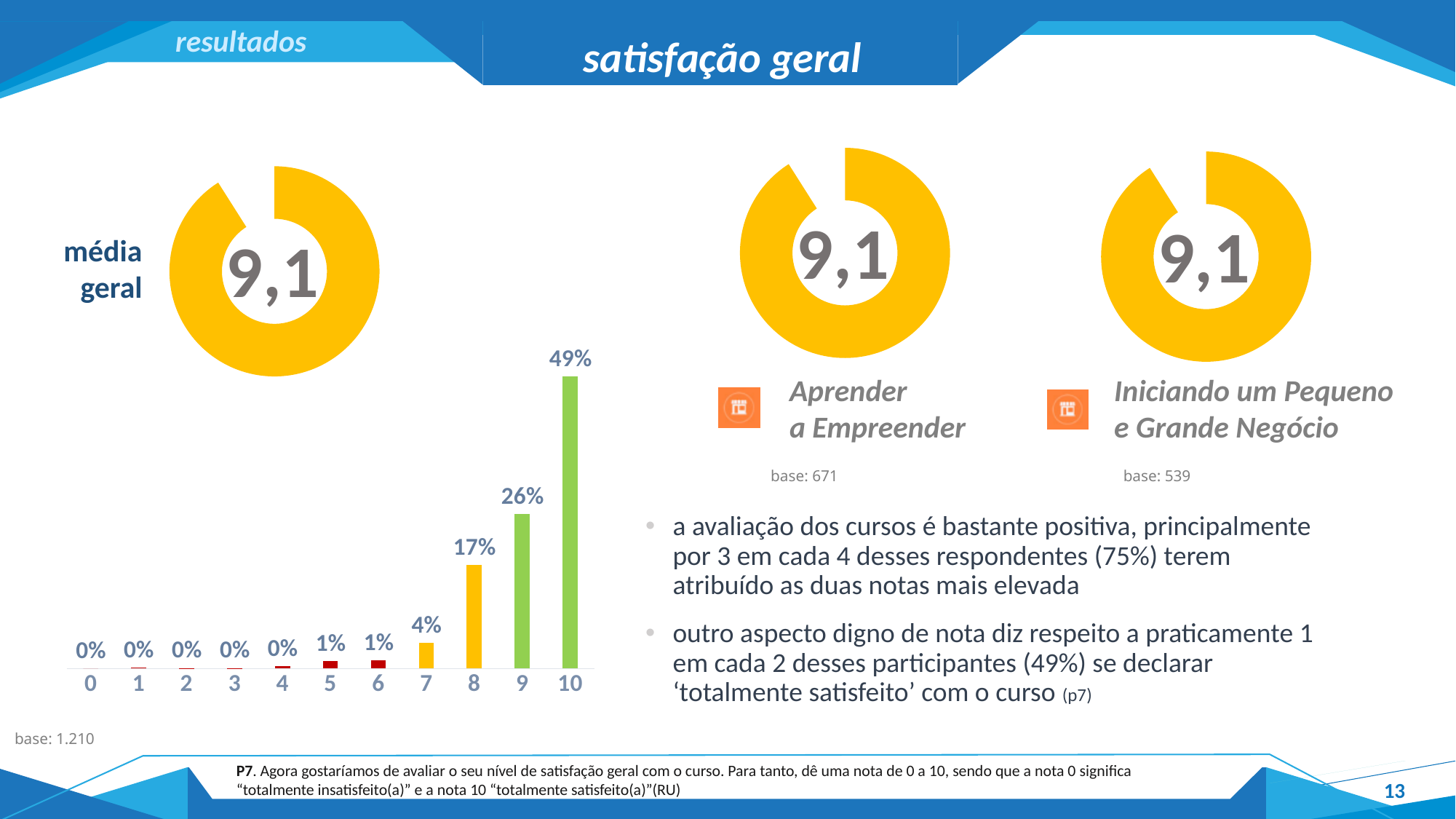
What is the 'média geral' value shown in the large donut chart on the left? 9,1 In the bar chart at the bottom left, what percentage of respondents gave a score of 7? 4% In the bar chart at the bottom left, what percentage of respondents gave a score of 8? 17% What average score is shown in the donut chart for 'Aprender a Empreender'? 9,1 In the bar chart at the bottom left, how many score categories are shown on the x axis? 11 In the bar chart at the bottom left, what is the combined percentage for scores 9 and 10? 75% In the bar chart at the bottom left, what is the difference in percentage points between the scores 10 and 9? 23 In the bar chart at the bottom left, which score has the highest percentage of respondents? 10 In the bar chart at the bottom left, which has a larger percentage: score 8 or score 9? 9 In the bar chart at the bottom left, do the percentages rise or fall as the score increases from 7 to 10? rise In the bar chart at the bottom left, what percentage of respondents gave a score of 10? 49% What type of chart is used at the bottom left to show the distribution of scores? bar chart